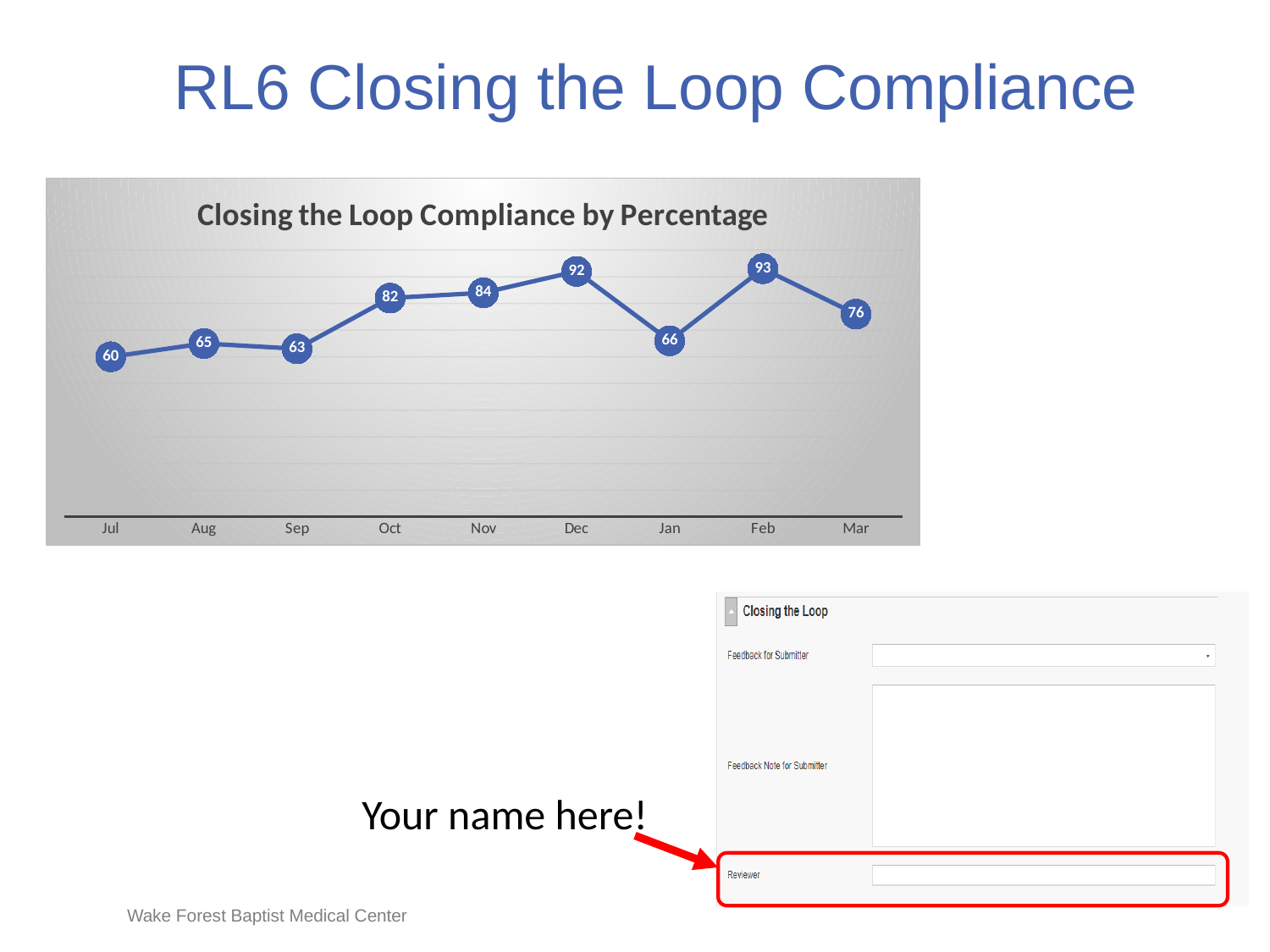
What is the value for Jan? 66 Which month has the highest value? Feb Which is larger, the value for Nov or the value for Mar? Nov What is the title of the chart? Closing the Loop Compliance by Percentage What is the value for Oct? 82 What is the difference between the values for Feb and Jan? 27 Which month has the lowest value? Jul What is the difference between the values for Dec and Jul? 32 What kind of chart is shown? Line chart What is the value for Mar? 76 How many months are plotted on the x axis? 9 Which is larger, the value for Aug or the value for Sep? Aug